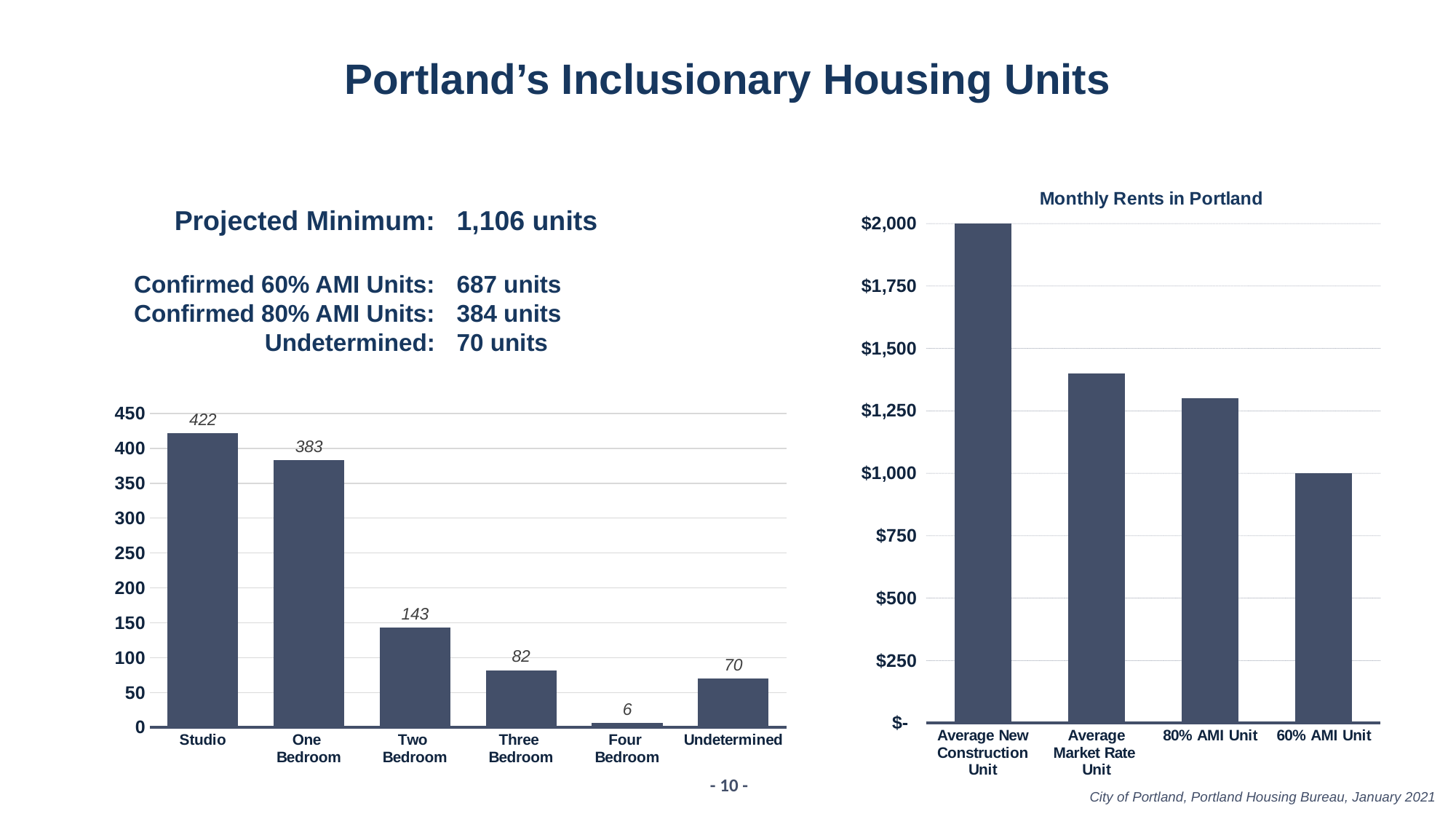
What kind of chart is the Monthly Rents in Portland chart? Bar chart In the left chart, how many units are shown for Studio? 422 In the Monthly Rents in Portland chart, which category has the highest rent? Average New Construction Unit In the left chart, which is larger, Three Bedroom or Undetermined? Three Bedroom How many categories are shown in the left chart? 6 In the left chart, which category has the lowest value? Four Bedroom In the Monthly Rents in Portland chart, do the values rise or fall from left to right? Fall In the left chart, what is the difference between the Studio and One Bedroom values? 39 In the Monthly Rents in Portland chart, is the value for Average Market Rate Unit greater or less than $1,250? greater In the left chart, which category has the highest value? Studio In the left chart, how many units are shown for Two Bedroom? 143 In the Monthly Rents in Portland chart, is the value for 80% AMI Unit greater or less than $1,500? less